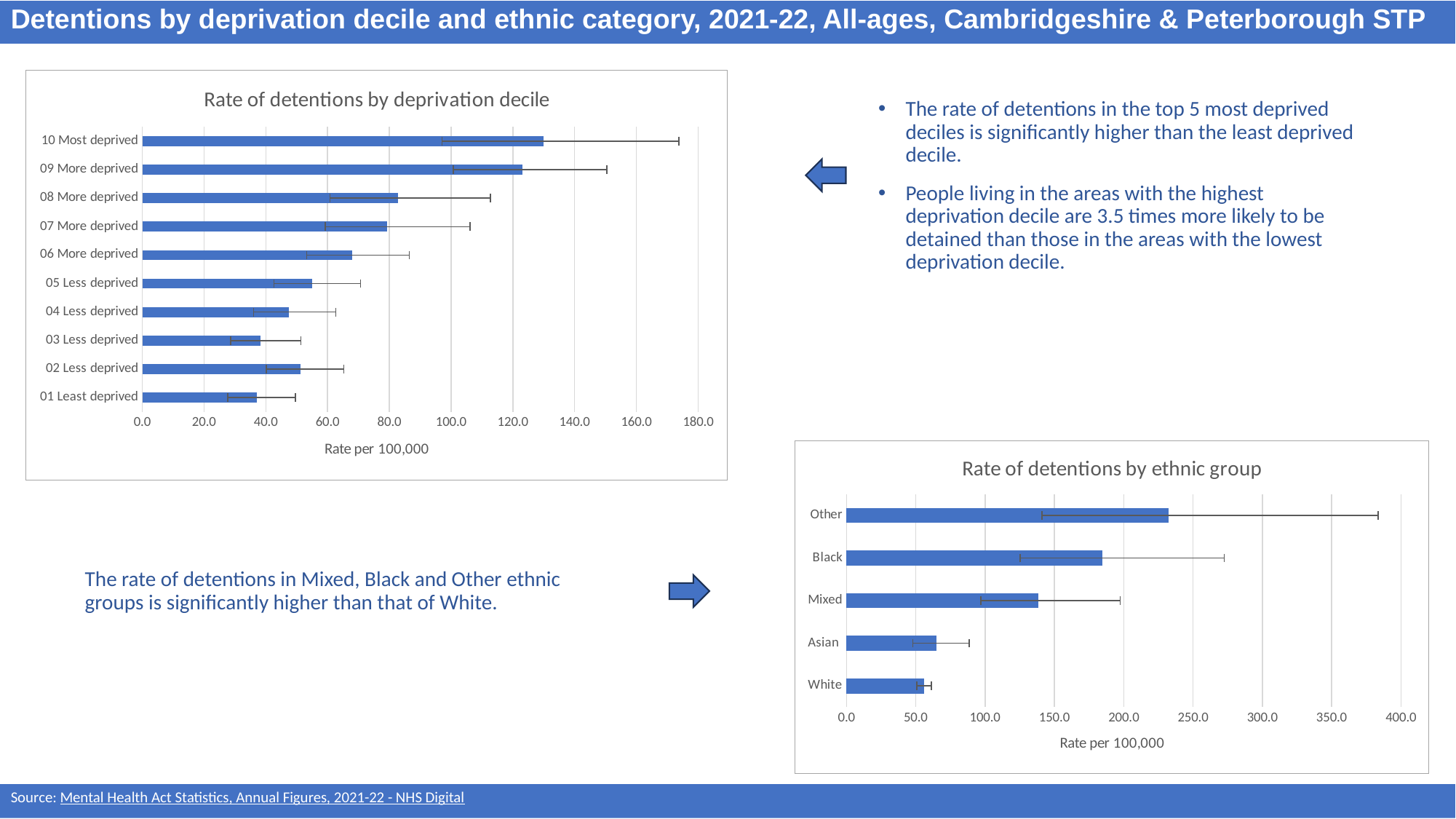
In the 'Rate of detentions by ethnic group' chart, which ethnic group has the highest rate? Other What is the x-axis label of the 'Rate of detentions by deprivation decile' chart? Rate per 100,000 In the 'Rate of detentions by deprivation decile' chart, is the value for 01 Least deprived greater or less than 60.0? less In the 'Rate of detentions by ethnic group' chart, which is larger, the value for Black or Mixed? Black In the 'Rate of detentions by deprivation decile' chart, which decile has the highest rate? 10 Most deprived In the 'Rate of detentions by ethnic group' chart, how many ethnic groups are plotted? 5 What kind of chart is 'Rate of detentions by deprivation decile'? Bar chart In the 'Rate of detentions by ethnic group' chart, is the value for Other greater or less than 200.0? greater In the 'Rate of detentions by ethnic group' chart, is the value for White greater or less than 100.0? less In the 'Rate of detentions by deprivation decile' chart, which is larger, the value for 09 More deprived or 06 More deprived? 09 More deprived In the 'Rate of detentions by deprivation decile' chart, how many deprivation deciles are plotted? 10